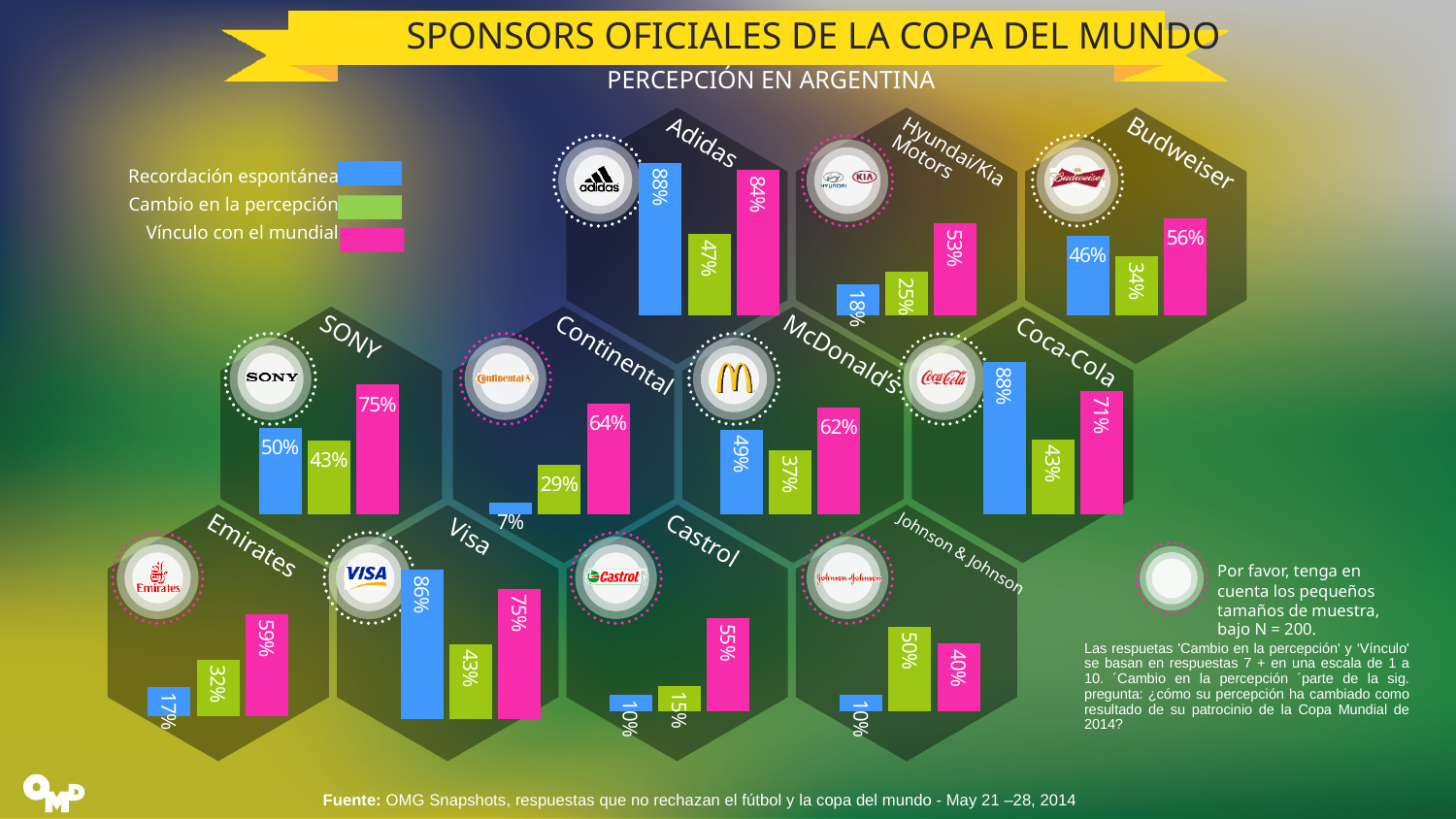
How many measures does the legend list for each sponsor chart? 3 In the Castrol chart, which of the three measures has the lowest value? Recordación espontánea Which colour represents Vínculo con el mundial in the legend? Pink In the Budweiser chart, what is the difference between Vínculo con el mundial and Cambio en la percepción? 22% In the Coca-Cola chart, what is the difference between Recordación espontánea and Vínculo con el mundial? 17% In the Johnson & Johnson chart, what is the value for Cambio en la percepción? 50% In the Continental chart, what is the value for Vínculo con el mundial? 64% In the Hyundai/Kia Motors chart, which of the three measures has the highest value? Vínculo con el mundial In the Adidas chart, what is the value for Recordación espontánea? 88% What kind of chart is used for each sponsor on the slide? Bar chart In the Visa chart, what is the value for Recordación espontánea? 86% In the Sony chart, which is larger: Recordación espontánea or Cambio en la percepción? Recordación espontánea